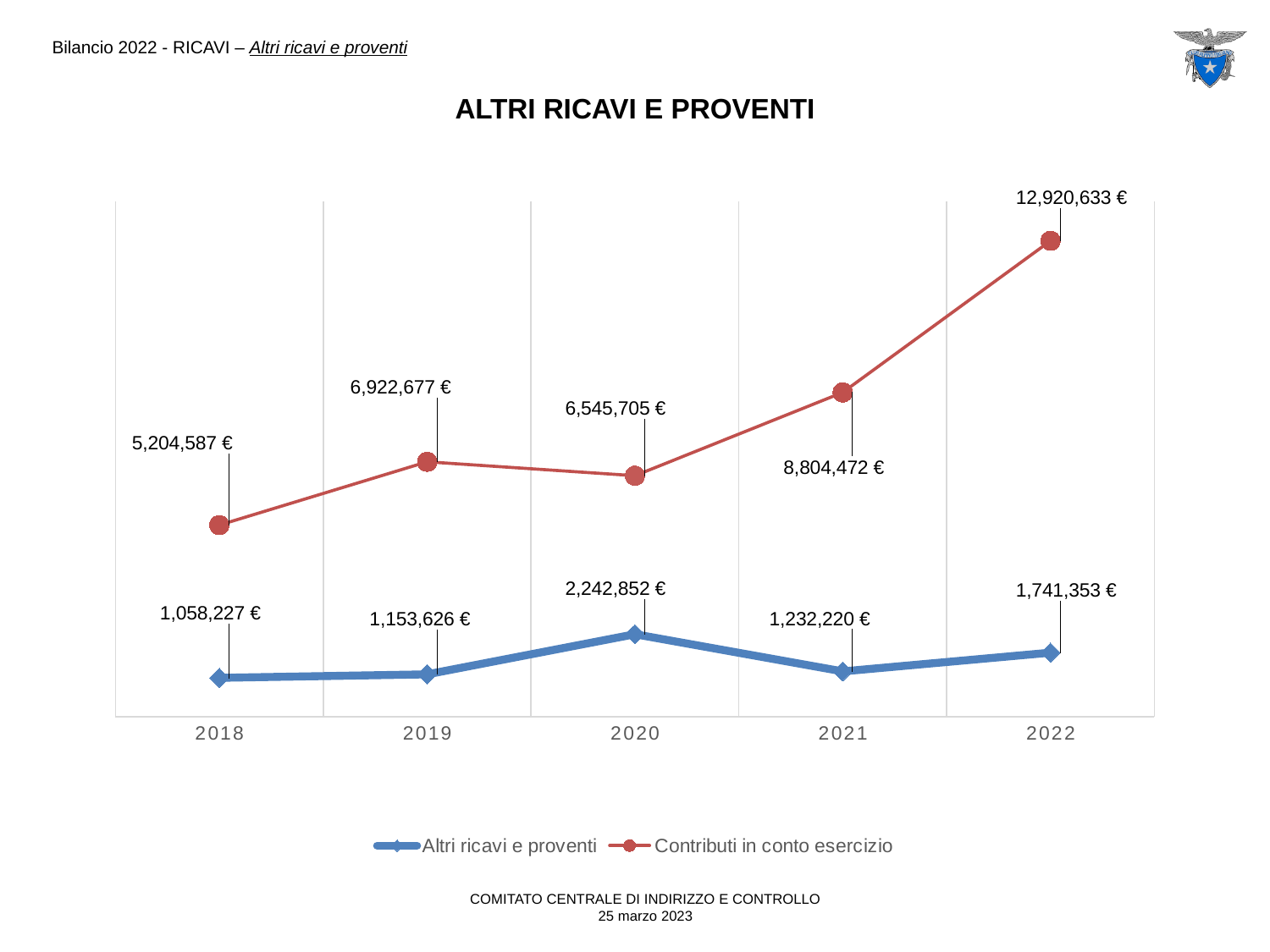
In which year is Altri ricavi e proventi lowest? 2018 What type of chart is shown on the slide? Line chart What is the value of Contributi in conto esercizio in 2022? 12,920,633 € What is the difference between Contributi in conto esercizio in 2022 and in 2021? 4,116,161 € What is the value of Altri ricavi e proventi in 2020? 2,242,852 € Which is larger for Contributi in conto esercizio: the 2019 value or the 2020 value? 2019 How many years are shown on the x axis? 5 What is the title of the chart? ALTRI RICAVI E PROVENTI How many series does the legend list? 2 In which year is Contributi in conto esercizio highest? 2022 What is the value of Contributi in conto esercizio in 2018? 5,204,587 € What is the value of Altri ricavi e proventi in 2021? 1,232,220 €